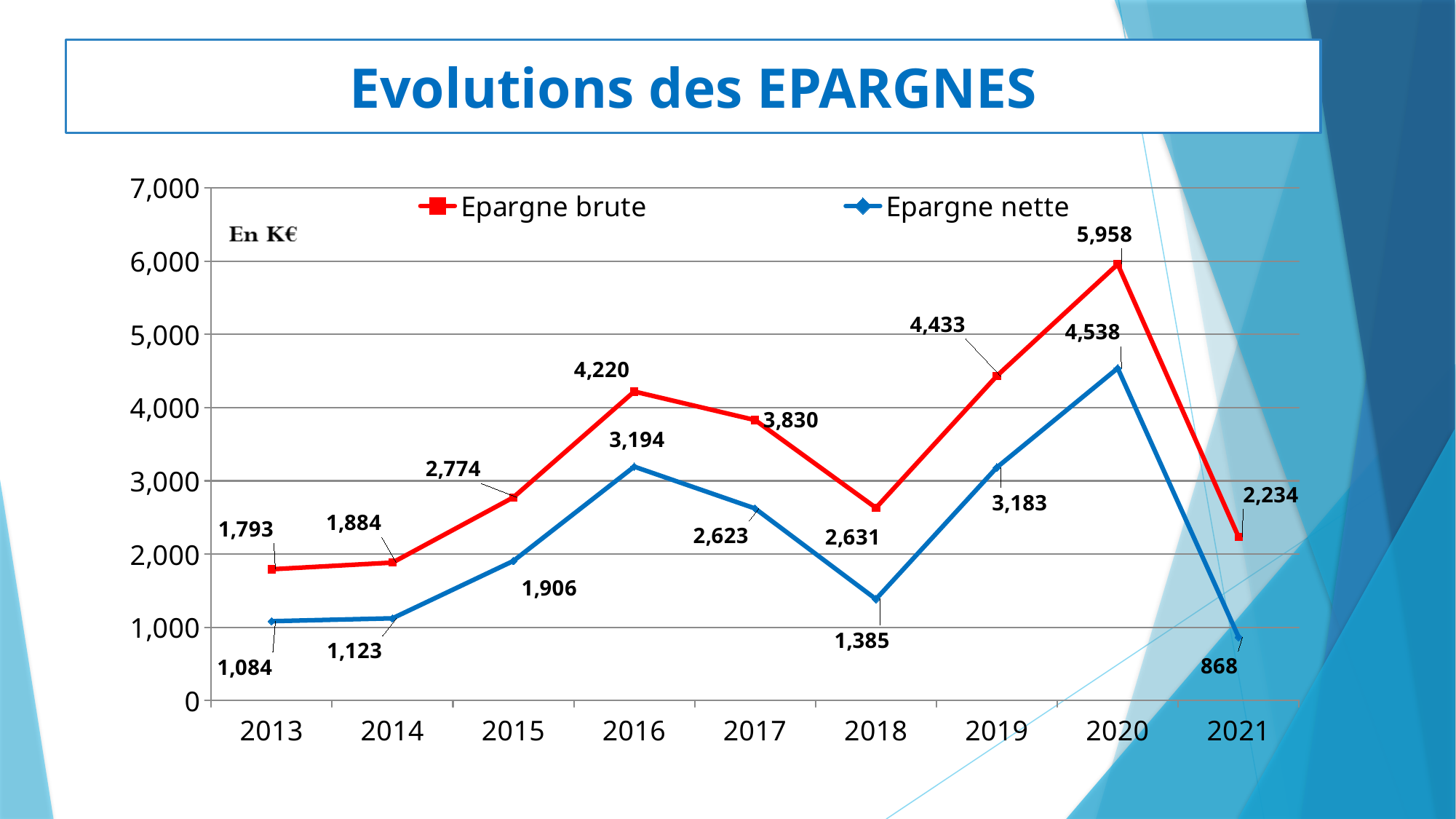
What is the value of Epargne nette in 2018? 1,385 What is the value of Epargne nette in 2021? 868 Does Epargne brute rise or fall from 2020 to 2021? Fall Which is larger in 2016: Epargne brute or Epargne nette? Epargne brute What is the difference between Epargne brute and Epargne nette in 2020? 1,420 In which year is Epargne nette lowest? 2021 In which year is Epargne brute highest? 2020 What is the value of Epargne brute in 2020? 5,958 What kind of chart is shown on the slide? Line chart What is the title of the chart? Evolutions des EPARGNES How many series does the legend list? 2 How many years are shown on the x axis? 9